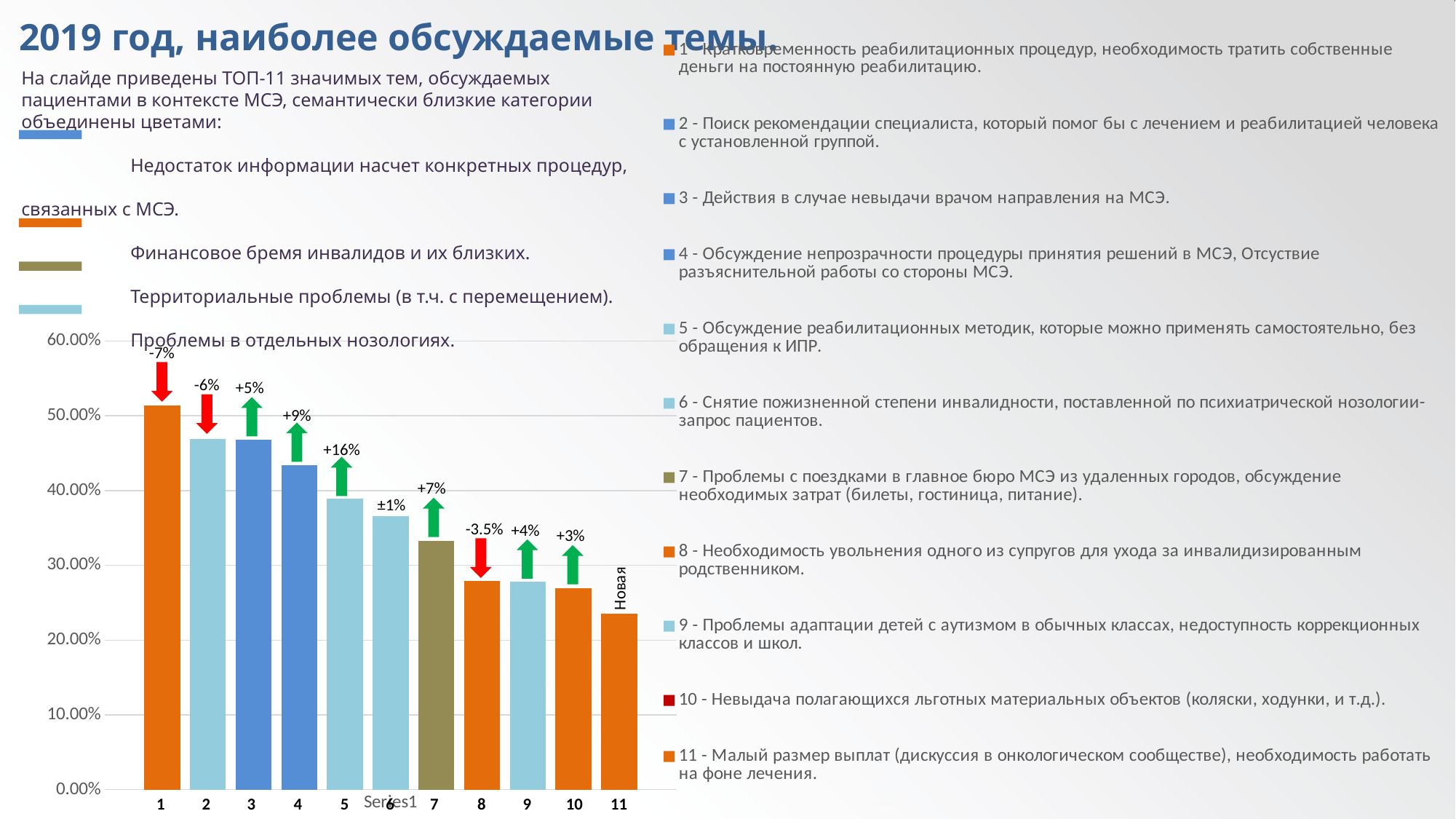
Is the value for category 5 greater or less than 40.00%? less How many bars (categories) are plotted in the chart? 11 Is the value for category 1 greater or less than 50.00%? greater Which category has the lowest bar in the chart? 11 What change annotation is shown above the bar for category 5? +16% What word is written on the bar for category 11? Новая Do the bar values rise or fall from category 1 to category 11? fall Is the value for category 11 greater or less than 30.00%? less Which is larger, the value for category 4 or the value for category 8? 4 Which category has the highest bar in the chart? 1 What kind of chart is shown on the slide? bar chart